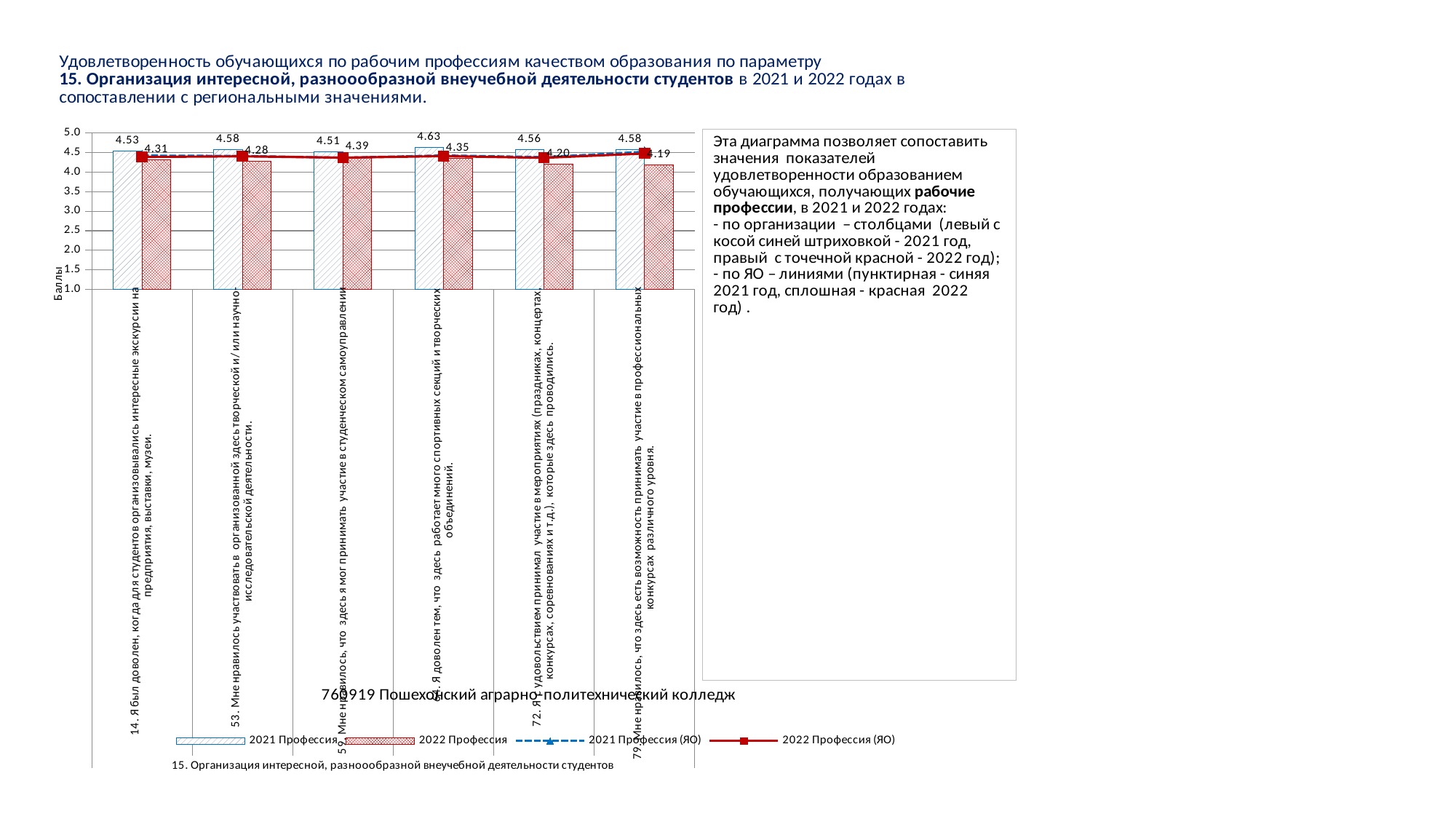
For item 72 (участие в мероприятиях), which is larger: the 2021 Профессия value or the 2022 Профессия value? 2021 Профессия Which item has the lowest 2022 Профессия value? 79. Мне нравилось, что здесь есть возможность принимать участие в профессиональных конкурсах различного уровня. Which item has the highest 2022 Профессия value? 59. Мне нравилось, что здесь я мог принимать участие в студенческом самоуправлении What is the 2022 Профессия value for item 79 (возможность принимать участие в профессиональных конкурсах различного уровня)? 4.19 How many series does the legend list? 4 What is the label of the vertical axis? Баллы How many survey items (categories) are shown on the x axis? 6 What is the 2022 Профессия value for item 14 (интересные экскурсии на предприятия, выставки, музеи)? 4.31 What is the difference between the 2021 Профессия and 2022 Профессия values for item 64? 0.28 What is the 2021 Профессия value for item 64 (Я доволен тем, что здесь работает много спортивных секций и творческих объединений)? 4.63 What kind of chart is this? Bar chart with line series Which item has the highest 2021 Профессия value? 64. Я доволен тем, что здесь работает много спортивных секций и творческих объединений.